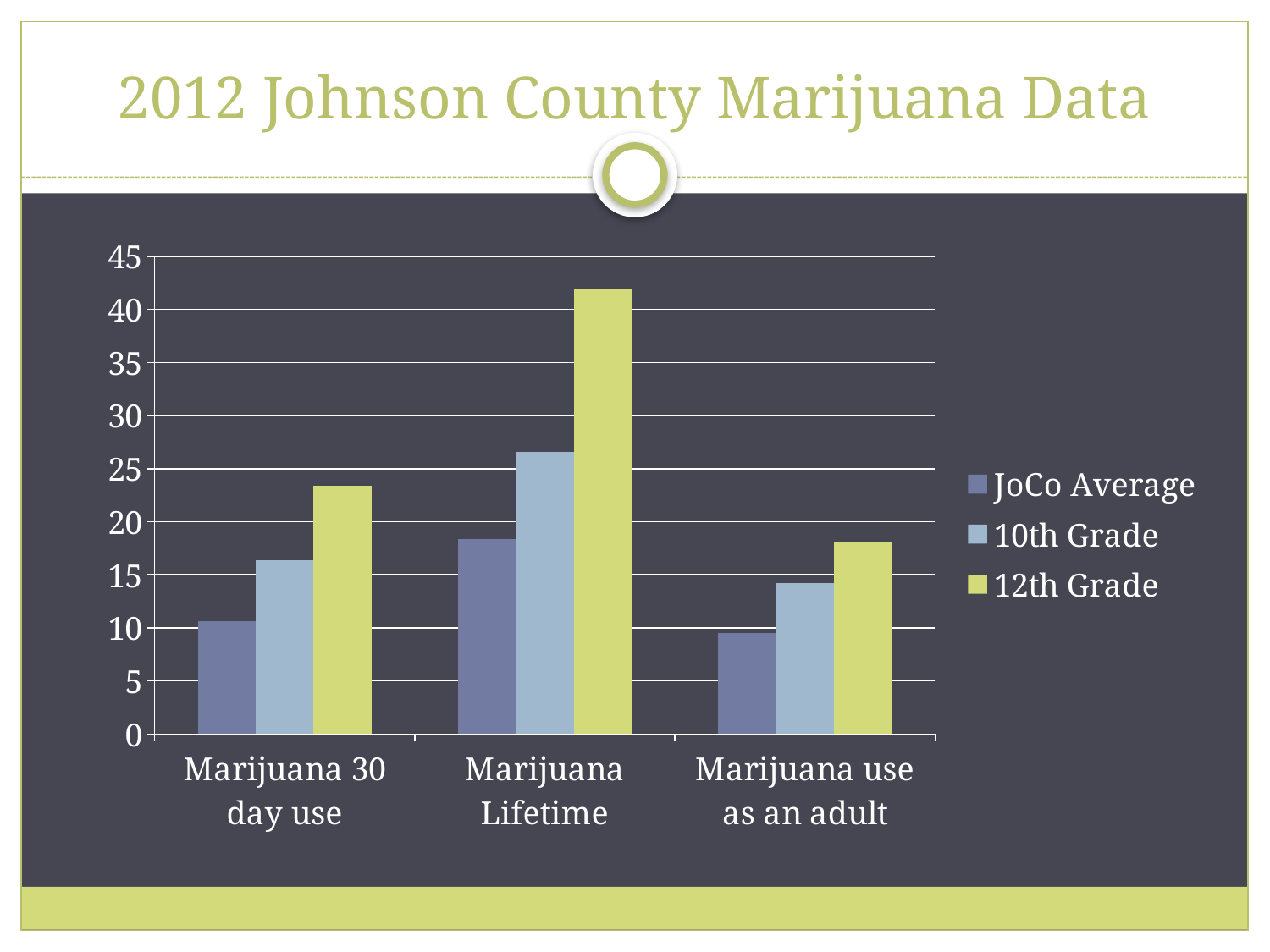
Which series has the tallest bar in every category? 12th Grade How many categories are shown on the x axis? 3 How many series does the legend list? 3 What is the title of the slide containing the chart? 2012 Johnson County Marijuana Data Is the 12th Grade value for Marijuana Lifetime greater or less than 40? greater Is the 10th Grade value for Marijuana 30 day use greater or less than 15? greater Which is larger: the 10th Grade value for Marijuana Lifetime or the 12th Grade value for Marijuana 30 day use? 10th Grade value for Marijuana Lifetime Which category has the lowest JoCo Average value? Marijuana use as an adult Which legend entry is shown in yellow-green? 12th Grade What kind of chart is shown on the slide? bar chart Which category has the highest 12th Grade value? Marijuana Lifetime